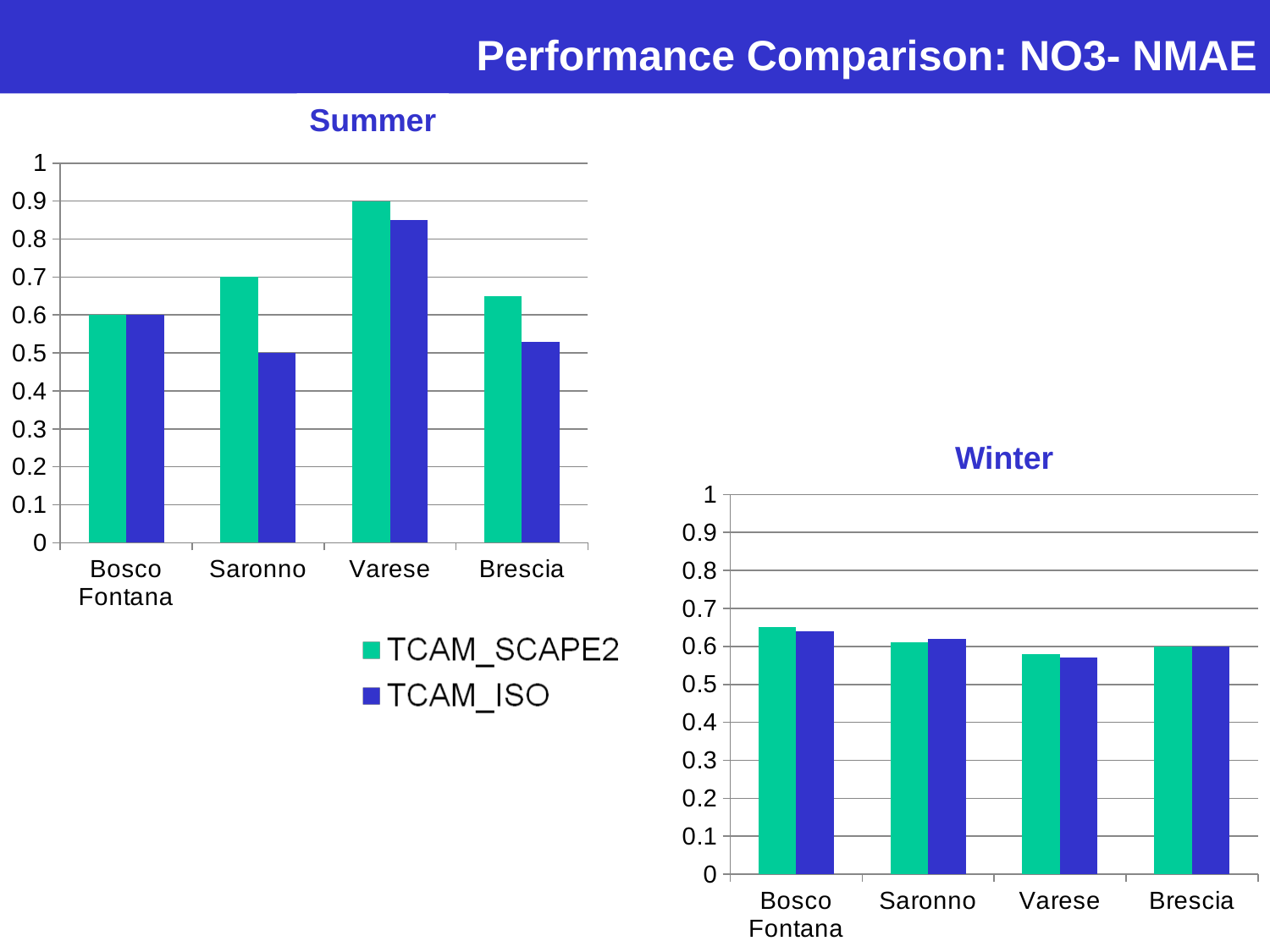
In the Winter chart, what is the TCAM_SCAPE2 value for Brescia? 0.6 In the Summer chart, is the TCAM_ISO value for Brescia greater or less than 0.6? less What kind of chart is the Summer chart? bar chart How many series does the legend list? 2 In the Winter chart, which category has the highest TCAM_SCAPE2 value? Bosco Fontana In the Winter chart, which category has the lowest TCAM_ISO value? Varese In the Summer chart, which category has the highest TCAM_SCAPE2 value? Varese How many categories are shown on the x axis of the Winter chart? 4 In the Summer chart, which is larger for Saronno, TCAM_SCAPE2 or TCAM_ISO? TCAM_SCAPE2 In the Summer chart, what is the TCAM_SCAPE2 value for Varese? 0.9 In the Summer chart, what is the TCAM_ISO value for Saronno? 0.5 In the Summer chart, what is the TCAM_SCAPE2 value for Saronno? 0.7